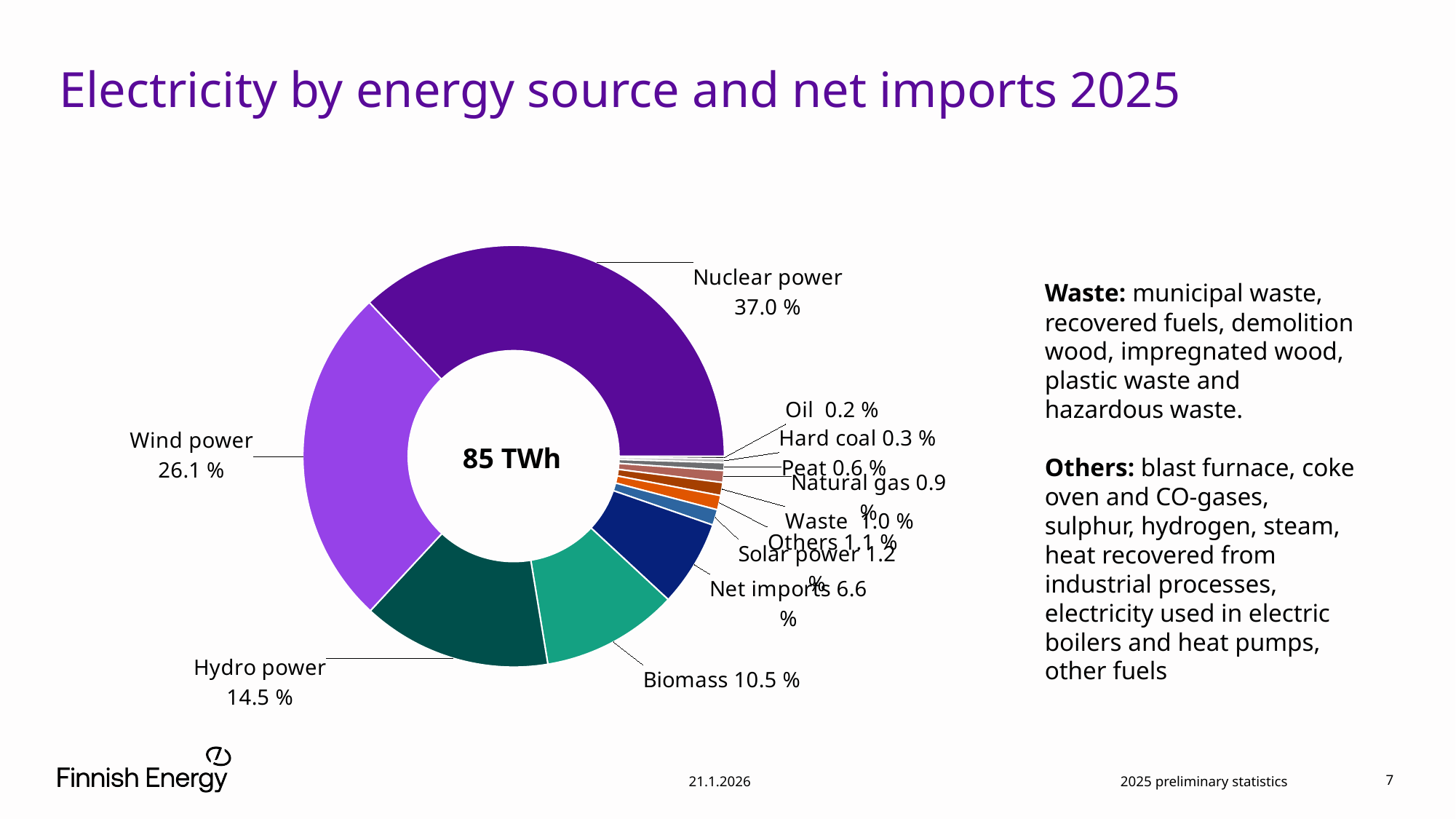
What is the value shown for Net imports? 6.6 % What is the title of the slide? Electricity by energy source and net imports 2025 What percentage is labelled for Hydro power? 14.5 % What share of the donut chart does Nuclear power account for? 37.0 % What total is printed in the centre of the chart? 85 TWh Which category has the smallest share in the chart? Oil Which energy source has the largest share in the chart? Nuclear power What kind of chart is shown on the slide? Donut (pie) chart What is the difference in percentage points between Nuclear power and Wind power? 10.9 What is the value shown for Wind power? 26.1 % How many categories are shown in the chart? 12 Which has a larger share, Biomass or Net imports? Biomass